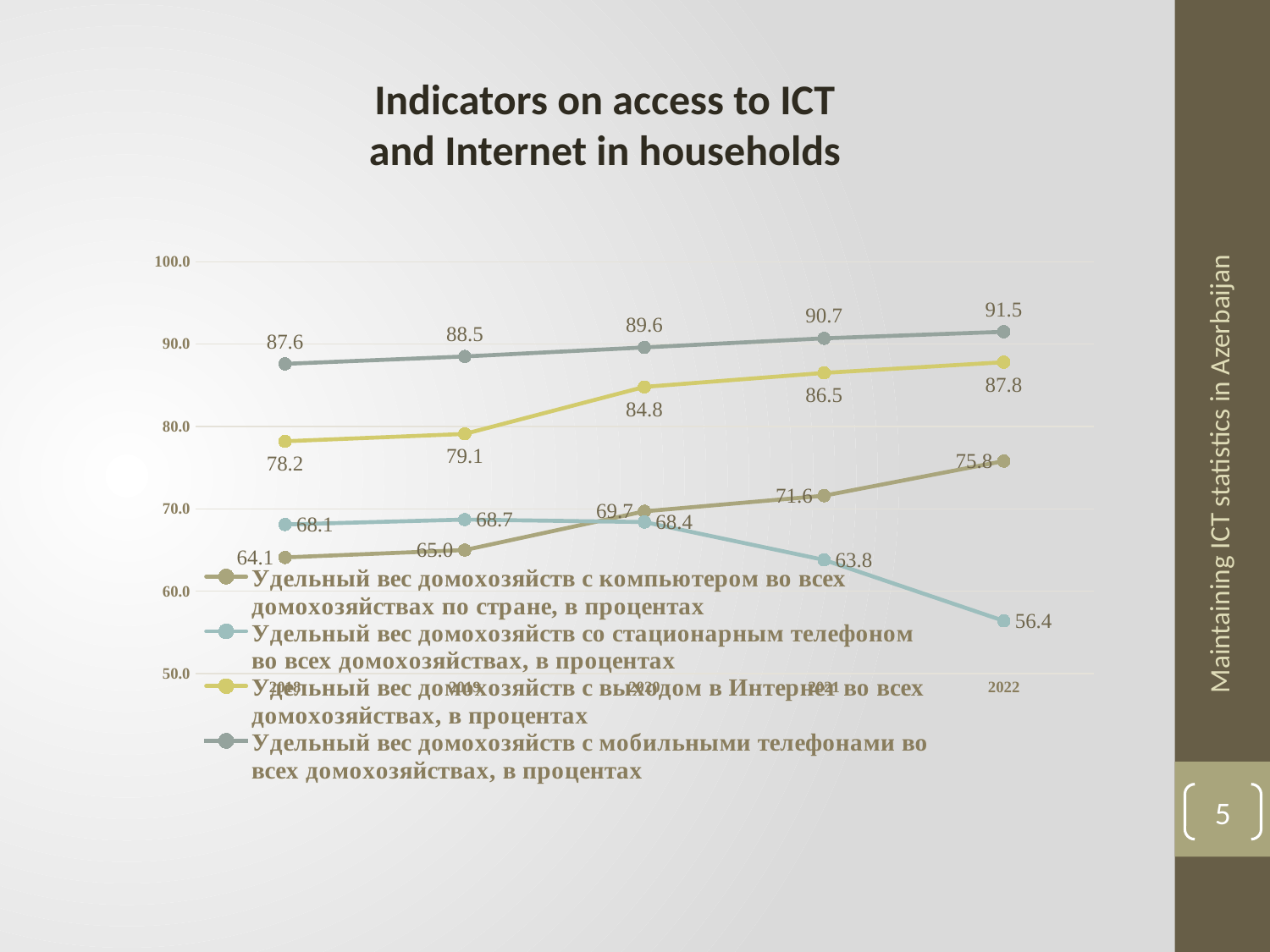
How many years are plotted along the x axis? 5 What is the value for 2020 of the series 'Удельный вес домохозяйств с выходом в Интернет во всех домохозяйствах, в процентах'? 84.8 Which series has the lowest value in 2022? Удельный вес домохозяйств со стационарным телефоном во всех домохозяйствах, в процентах What type of chart is shown on the slide? line chart Which series has the highest value in 2022? Удельный вес домохозяйств с мобильными телефонами во всех домохозяйствах, в процентах What is the value for 2022 of the series 'Удельный вес домохозяйств со стационарным телефоном во всех домохозяйствах, в процентах'? 56.4 Which is larger in 2018: the value for the series with Internet access (с выходом в Интернет) or the value for the series with a stationary telephone (со стационарным телефоном)? с выходом в Интернет (78.2) How many series does the legend list? 4 Does the series 'Удельный вес домохозяйств со стационарным телефоном во всех домохозяйствах, в процентах' rise or fall between 2020 and 2022? fall What is the value for 2022 of the series 'Удельный вес домохозяйств с мобильными телефонами во всех домохозяйствах, в процентах'? 91.5 What is the value for 2021 of the series 'Удельный вес домохозяйств с компьютером во всех домохозяйствах по стране, в процентах'? 71.6 What is the difference between the 2022 and 2018 values of the series 'Удельный вес домохозяйств с компьютером во всех домохозяйствах по стране, в процентах'? 11.7